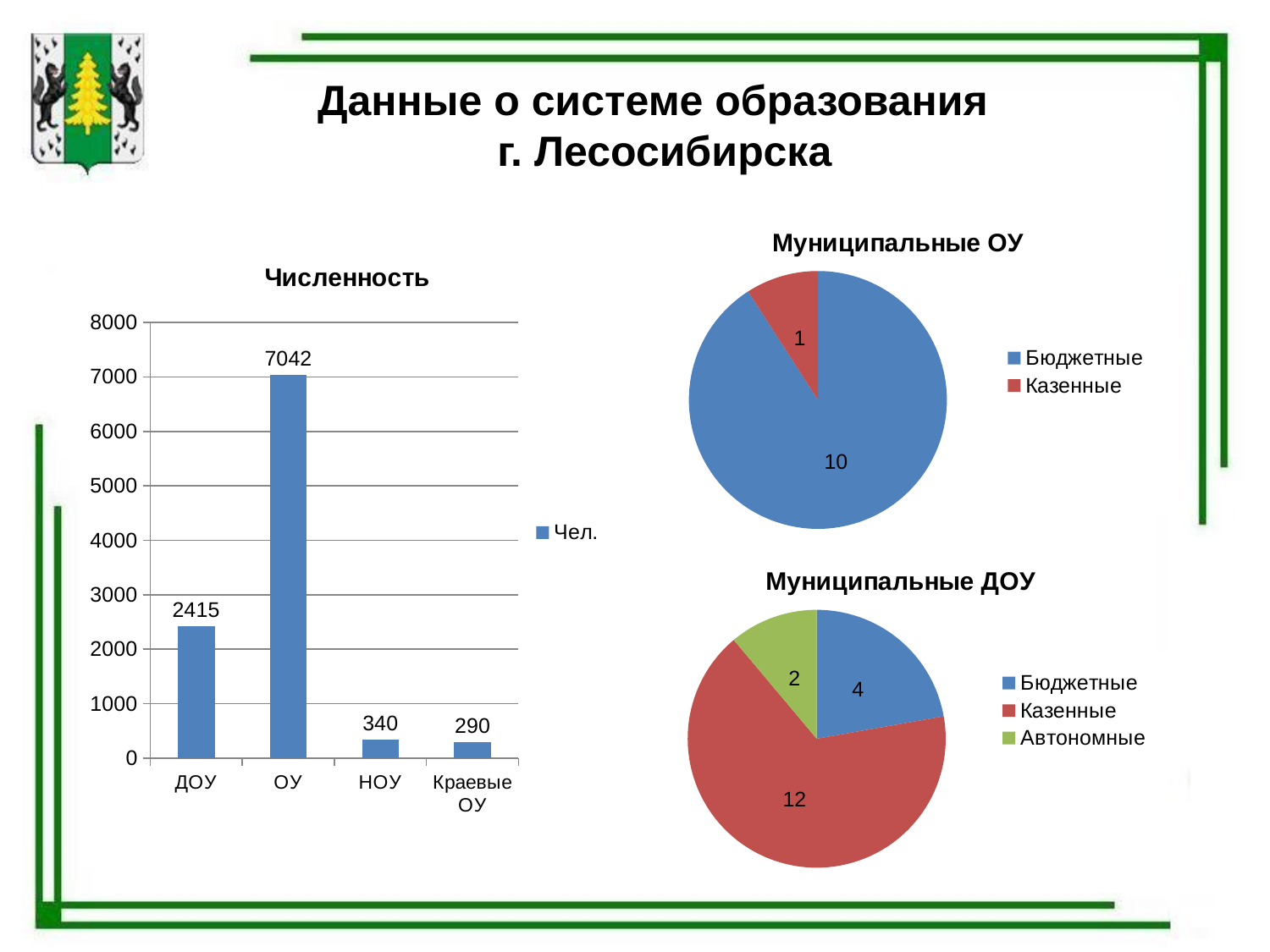
In the "Численность" bar chart, what is the value for ДОУ? 2415 In the "Численность" bar chart, which category has the highest value? ОУ What kind of chart is the "Численность" chart? Bar chart How many series does the legend of the "Муниципальные ДОУ" pie chart list? 3 In the "Муниципальные ДОУ" pie chart, which category has the smallest slice? Автономные In the "Муниципальные ОУ" pie chart, what is the value for Казенные? 1 In the "Муниципальные ДОУ" pie chart, what is the value for Казенные? 12 In the "Численность" bar chart, what is the value for ОУ? 7042 In the "Численность" bar chart, what is the difference between the values for ОУ and ДОУ? 4627 In the "Численность" bar chart, how many categories are shown on the x axis? 4 In the "Численность" bar chart, which category has the lowest value? Краевые ОУ In the "Муниципальные ОУ" pie chart, what is the total of all slices? 11